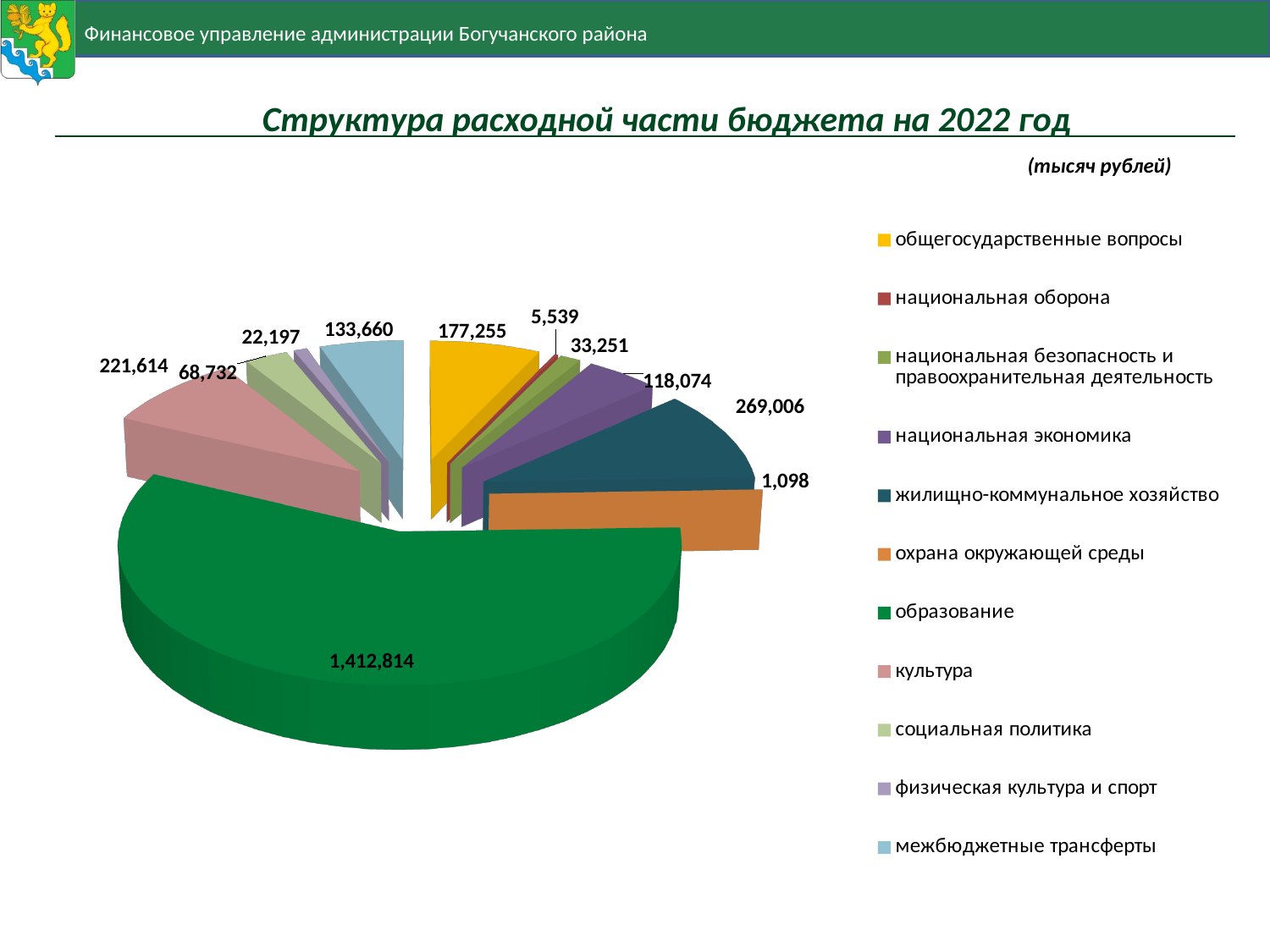
Which category has the smallest value? охрана окружающей среды What is the value for культура? 221,614 How many categories does the pie chart show? 11 What is the value for жилищно-коммунальное хозяйство? 269,006 What is the title of the chart? Структура расходной части бюджета на 2022 год What is the difference between the values for культура and национальная экономика? 103,540 What is the value for межбюджетные трансферты? 133,660 What is the value for образование? 1,412,814 Which is larger: общегосударственные вопросы or межбюджетные трансферты? общегосударственные вопросы Which category has the largest value? образование In what units are the values given? тысяч рублей What type of chart is shown on the slide? pie chart